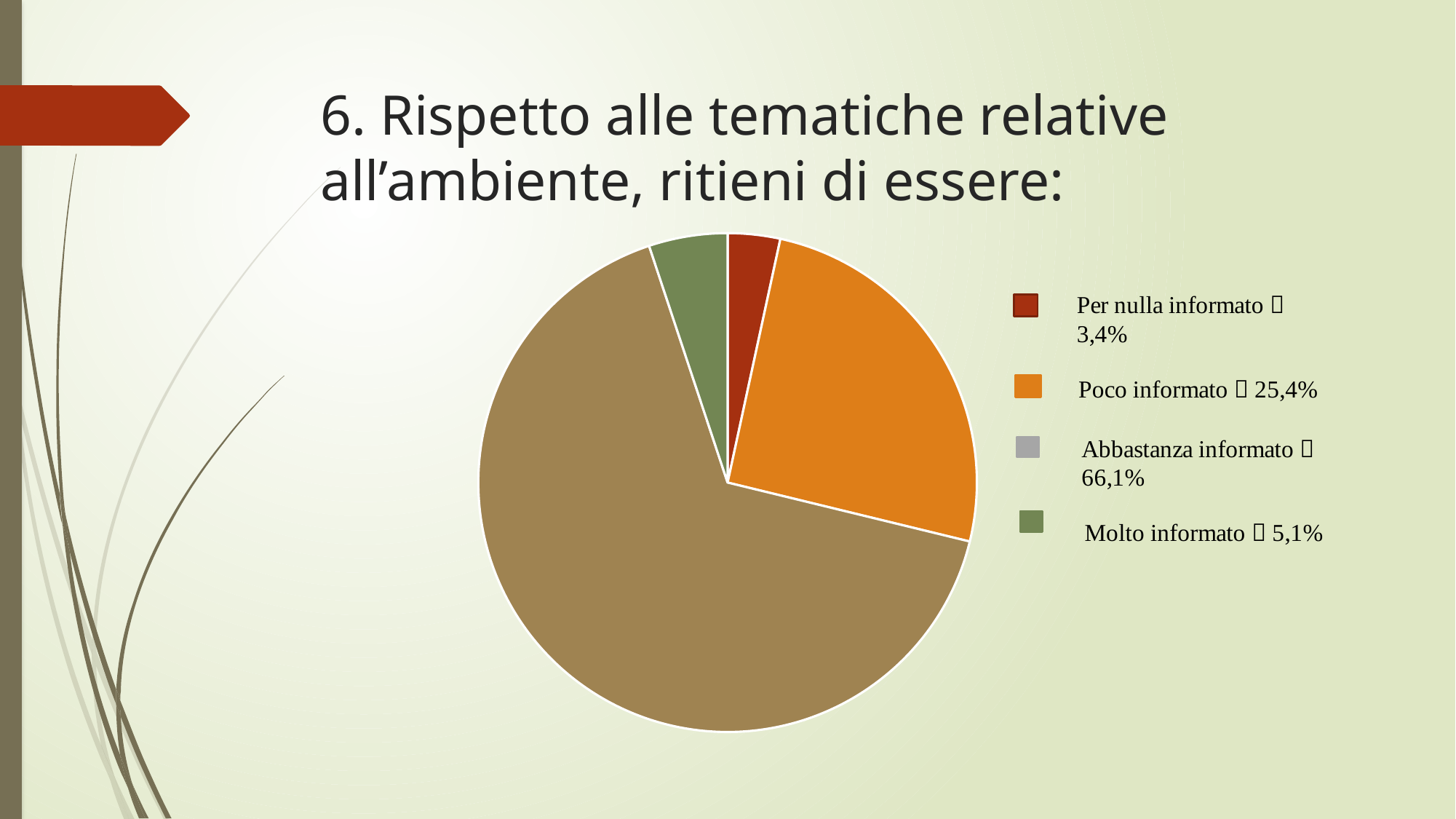
What colour is the slice for "Poco informato"? orange What percentage is shown for "Abbastanza informato"? 66,1% What percentage is shown for "Molto informato"? 5,1% What is the difference in percentage points between "Abbastanza informato" and "Poco informato"? 40,7 How many slices does the pie chart have? 4 What kind of chart is shown on the slide? pie chart What percentage is shown for "Poco informato"? 25,4% Which is larger, the share for "Poco informato" or the share for "Molto informato"? Poco informato What percentage is shown for "Per nulla informato"? 3,4% What is the difference in percentage points between "Molto informato" and "Per nulla informato"? 1,7 Which category has the smallest share of the pie? Per nulla informato Which category has the largest share of the pie? Abbastanza informato